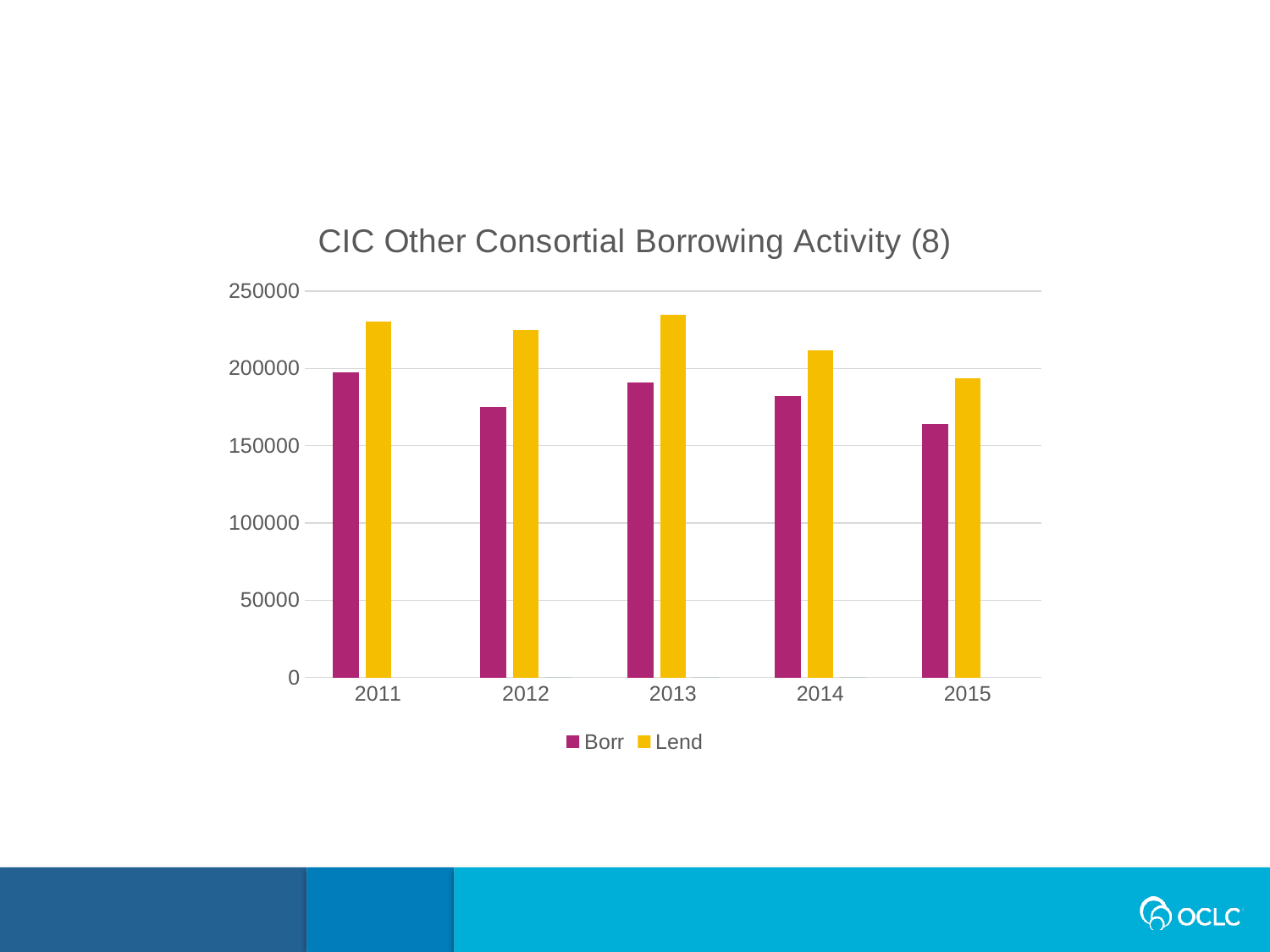
How many series does the legend list? 2 Is the Lend value for 2013 greater or less than 250000? less Is the Borr value for 2012 greater or less than 150000? greater Is the Lend value for 2011 greater or less than 200000? greater How many years are shown on the x axis? 5 Which is larger, the Lend value for 2014 or the Lend value for 2015? 2014 Do the Lend values rise or fall from 2013 to 2015? fall Which year has the lowest Lend value? 2015 Which year has the lowest Borr value? 2015 What kind of chart is shown on the slide? bar chart What is the title of the chart? CIC Other Consortial Borrowing Activity (8) In 2011, which is larger, Borr or Lend? Lend